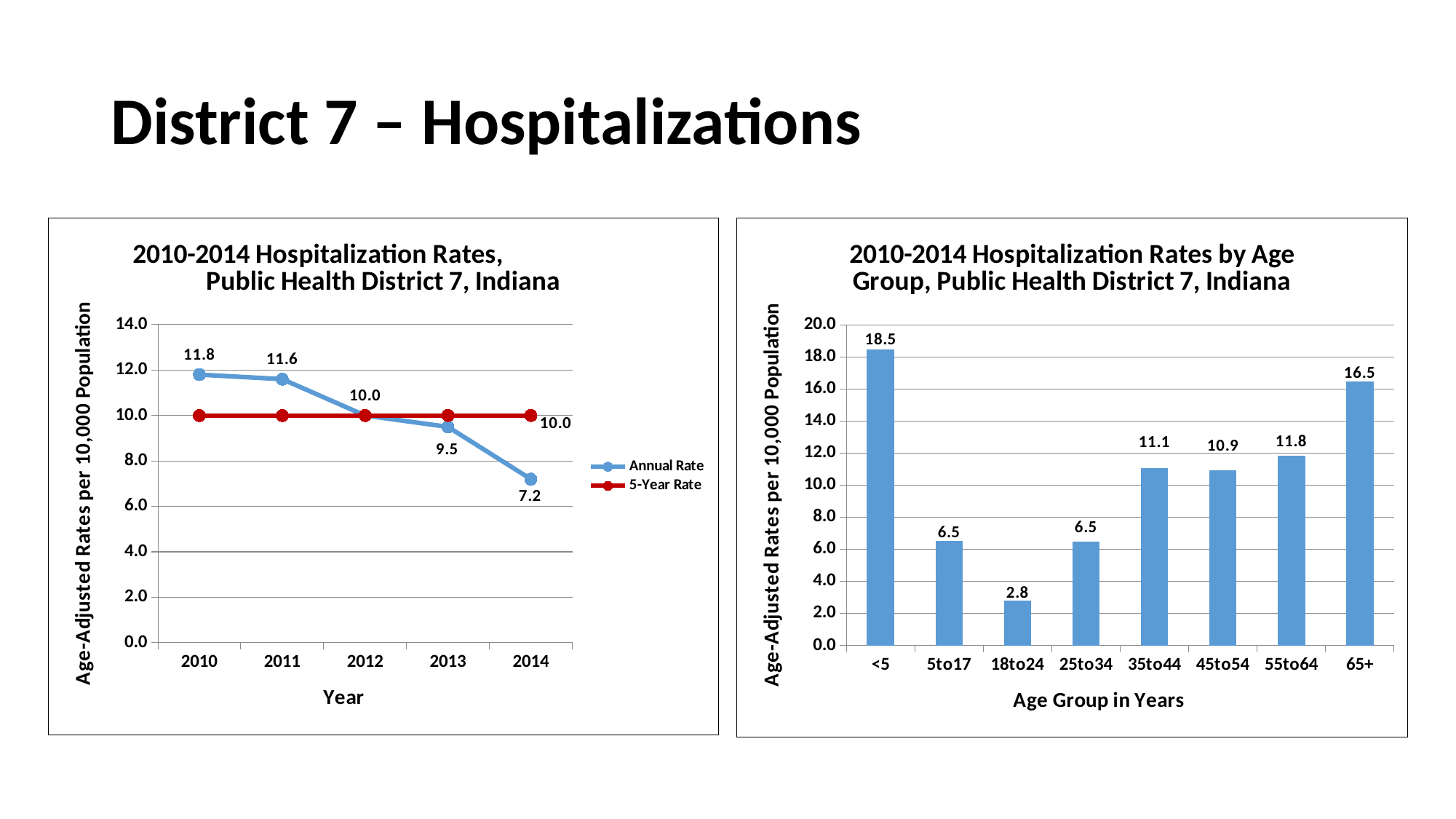
In the right chart (Hospitalization Rates by Age Group), what is the rate for the 65+ age group? 16.5 In the left chart (2010-2014 Hospitalization Rates), does the Annual Rate rise or fall from 2010 to 2014? fall In the left chart (2010-2014 Hospitalization Rates), how many series does the legend list? 2 In the left chart (2010-2014 Hospitalization Rates), what is the difference between the Annual Rate in 2010 and in 2014? 4.6 In the left chart (2010-2014 Hospitalization Rates), what is the Annual Rate for 2010? 11.8 In the right chart (Hospitalization Rates by Age Group), which age group has the highest rate? <5 In the right chart (Hospitalization Rates by Age Group), which is larger, the rate for 35to44 or for 45to54? 35to44 In the left chart (2010-2014 Hospitalization Rates), what is the 5-Year Rate? 10.0 In the left chart (2010-2014 Hospitalization Rates), what kind of chart is it? line chart In the left chart (2010-2014 Hospitalization Rates), what is the Annual Rate for 2014? 7.2 In the right chart (Hospitalization Rates by Age Group), how many age groups are shown? 8 In the right chart (Hospitalization Rates by Age Group), which age group has the lowest rate? 18to24